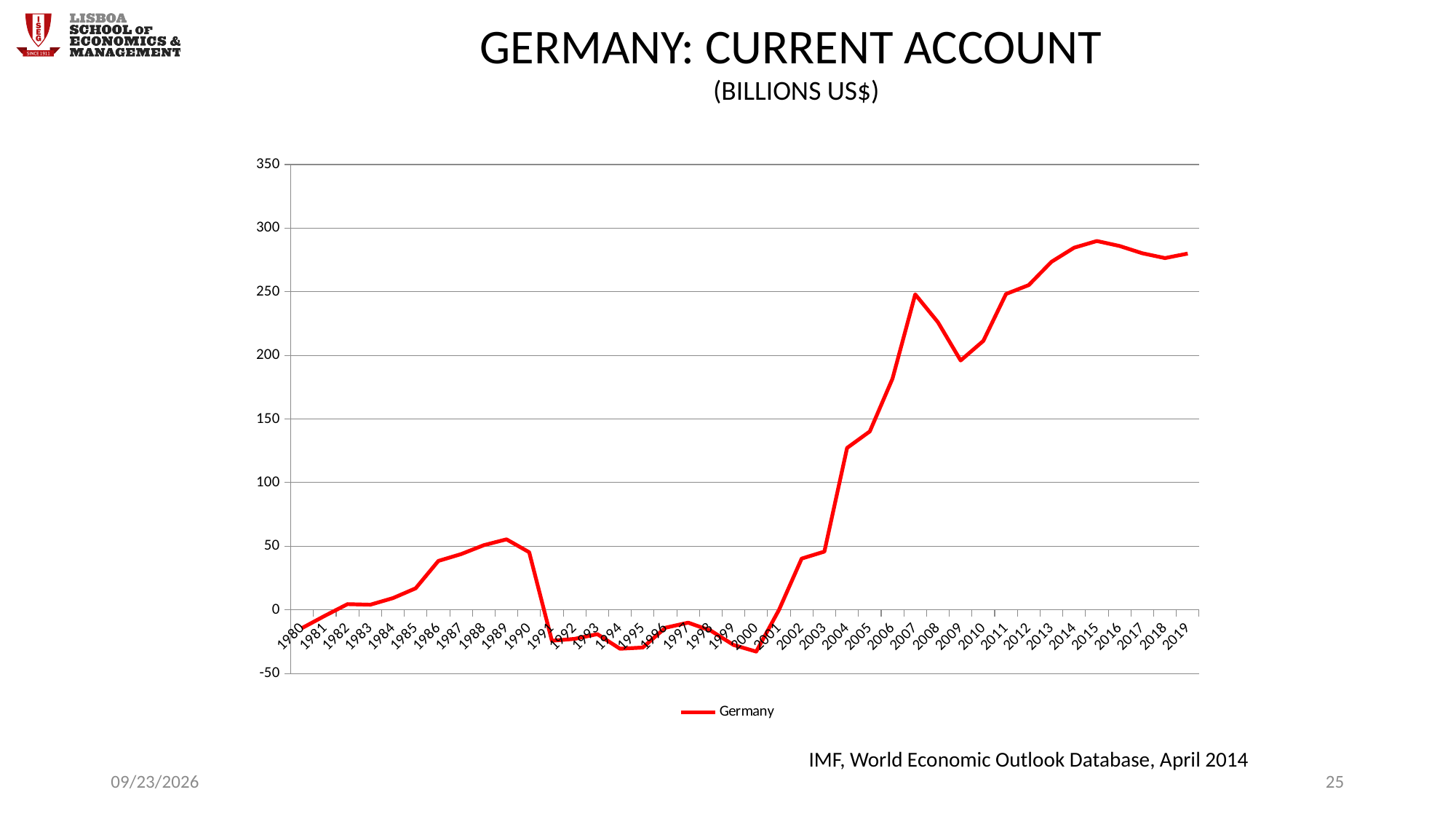
What kind of chart is shown on the slide? line chart Which is larger, the value for 1989 or the value for 2004? 2004 Does the current account rise or fall between 2002 and 2007? rise How many years are plotted along the x axis? 40 Is the value for 2000 greater or less than 0? less Which year has the highest current account value? 2015 What is the unit given in the chart's subtitle? Billions US$ How many series does the legend list? 1 Is the value for 2007 greater or less than 200? greater Is the value for 2015 greater or less than 250? greater Which is larger, the value for 2007 or the value for 2009? 2007